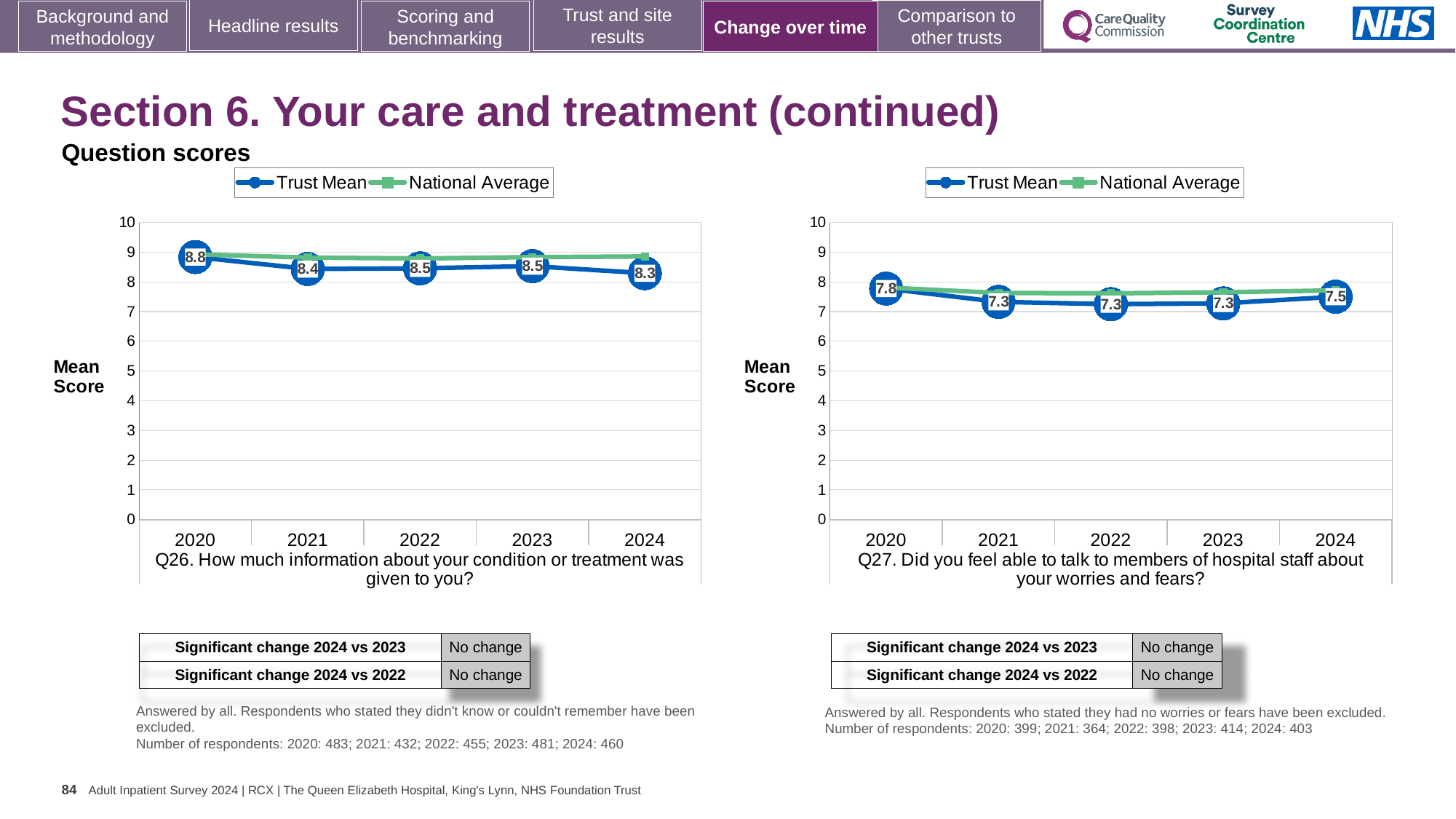
In the Q26 chart on the left, does the Trust Mean score rise or fall from 2020 to 2021? fall What kind of chart is the Q26 chart on the left? Line chart In the Q27 chart on the right, what is the Trust Mean score for 2024? 7.5 In the Q27 chart on the right, is the Trust Mean score for 2024 larger or smaller than the score for 2023? larger In the Q26 chart on the left, which year has the highest Trust Mean score? 2020 In the Q26 chart on the left, which year has the lowest Trust Mean score? 2024 In the Q26 chart on the left, what is the difference between the Trust Mean scores for 2020 and 2024? 0.5 How many series does the legend of the Q26 chart on the left list? 2 In the Q26 chart on the left, is the National Average value for 2024 greater or less than 8? greater In the Q26 chart on the left, what is the Trust Mean score for 2020? 8.8 In the Q27 chart on the right, which year has the highest Trust Mean score? 2020 How many years are plotted on the x axis of the Q27 chart on the right? 5